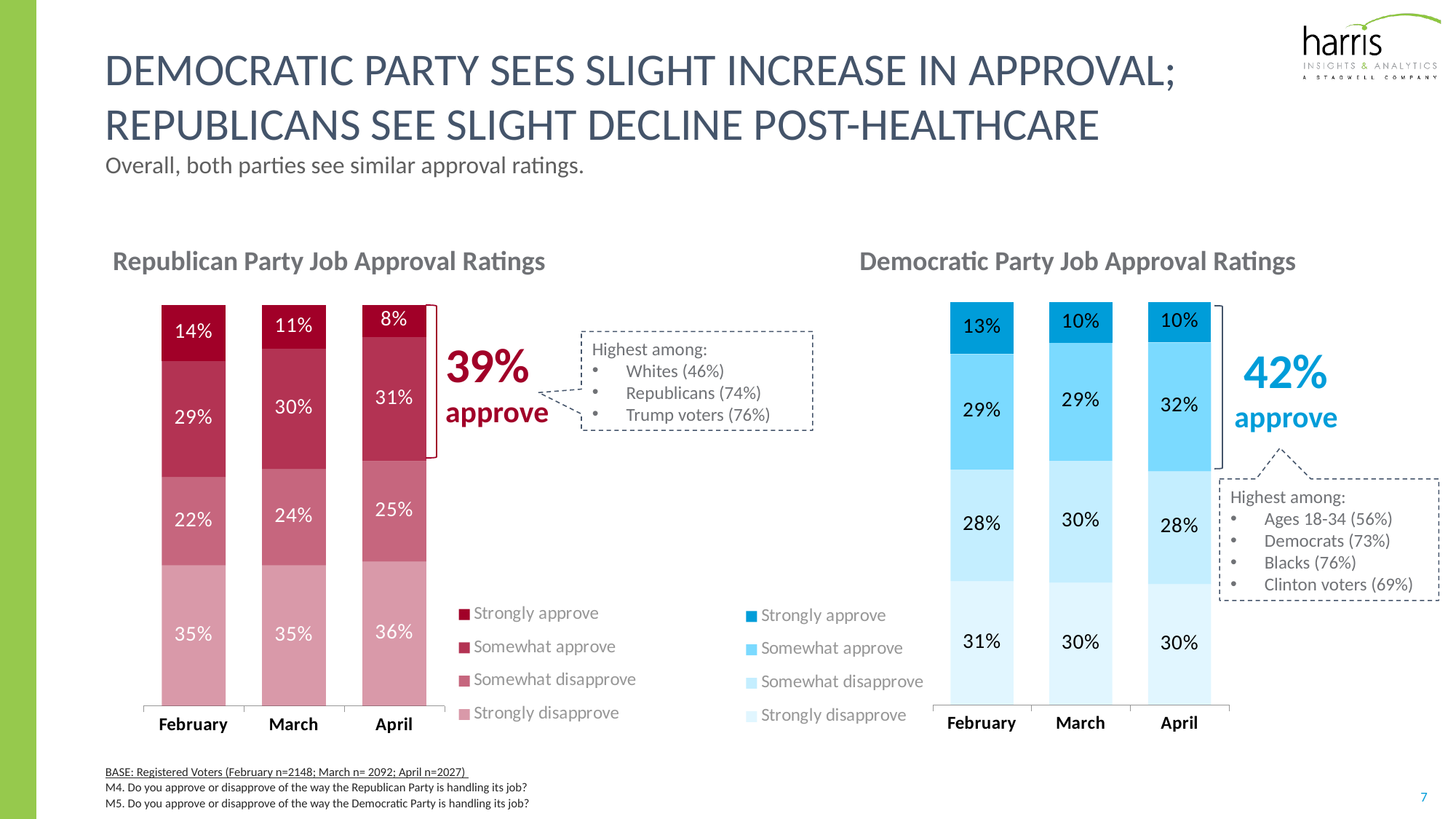
In the Democratic Party Job Approval Ratings chart, what is the Somewhat approve value for April? 32% In the Republican Party Job Approval Ratings chart, which month has the highest Strongly approve value? February In the Republican Party Job Approval Ratings chart, does the Somewhat approve value rise or fall from February to April? Rise In the Democratic Party Job Approval Ratings chart, which month has the lowest Somewhat disapprove value? February and April (both 28%) In the Republican Party Job Approval Ratings chart, what is the Strongly approve value for April? 8% How many months are shown on the x axis of the Republican Party Job Approval Ratings chart? 3 In the Democratic Party Job Approval Ratings chart, what is the Somewhat disapprove value for March? 30% In the Democratic Party Job Approval Ratings chart, which is larger: the Strongly approve value for February or for March? February How many series does the legend of the Democratic Party Job Approval Ratings chart list? 4 What type of chart is the Republican Party Job Approval Ratings chart? Stacked bar chart In the Republican Party Job Approval Ratings chart, what is the Strongly disapprove value for March? 35% In the Republican Party Job Approval Ratings chart, what is the difference between the Strongly approve values for February and April? 6%